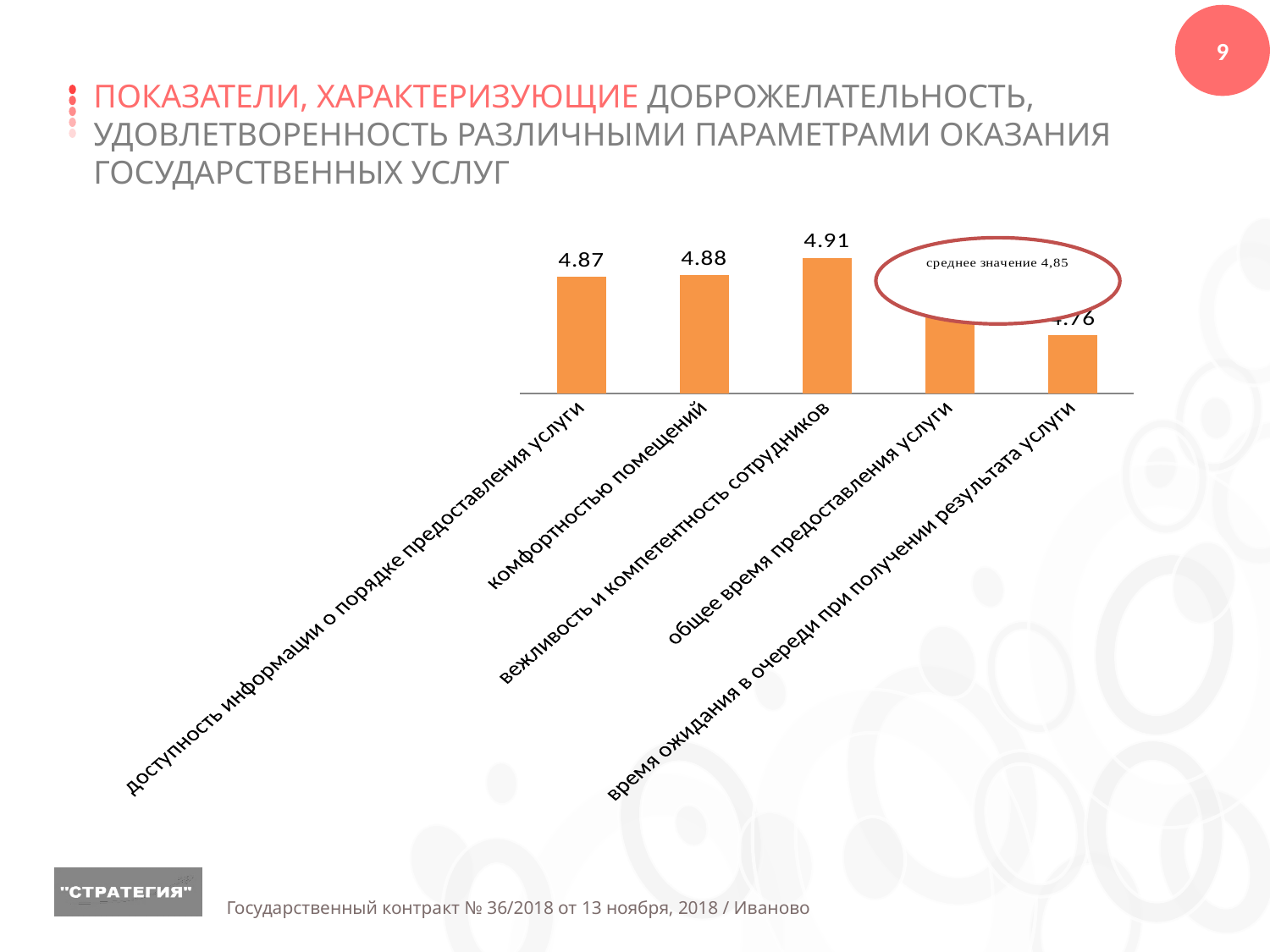
What is the difference between the values for 'вежливость и компетентность сотрудников' and 'доступность информации о порядке предоставления услуги'? 0.04 Which is larger: the value for 'комфортностью помещений' or for 'доступность информации о порядке предоставления услуги'? комфортностью помещений What is the value for 'вежливость и компетентность сотрудников'? 4.91 What is the difference between the values for 'комфортностью помещений' and 'доступность информации о порядке предоставления услуги'? 0.01 Which category has the highest value? вежливость и компетентность сотрудников What kind of chart is shown on the slide? bar chart What is the value for 'комфортностью помещений'? 4.88 What is the value for 'доступность информации о порядке предоставления услуги'? 4.87 Which is larger: the value for 'вежливость и компетентность сотрудников' or for 'комфортностью помещений'? вежливость и компетентность сотрудников What average value (среднее значение) is stated in the oval on the chart? 4,85 Which category has the lowest value? время ожидания в очереди при получении результата услуги How many categories are shown in the chart? 5